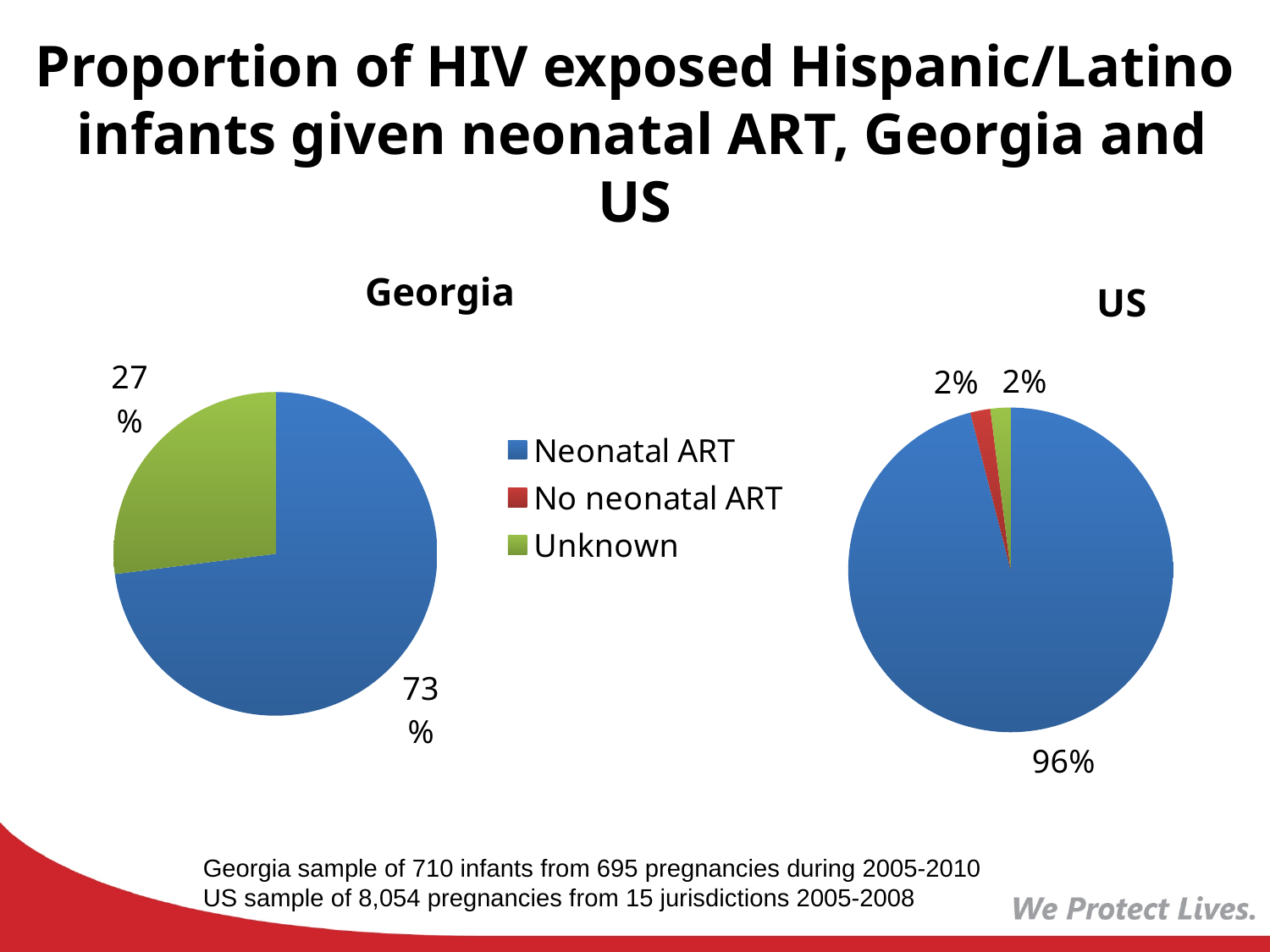
In the Georgia pie chart, what share of infants were given neonatal ART? 73% In the Georgia pie chart, what share is labelled Unknown? 27% In the US pie chart, what share of infants were given neonatal ART? 96% What colour represents Unknown in the legend? Green Which is larger: the Unknown share in the Georgia pie chart or the Unknown share in the US pie chart? Georgia In the Georgia pie chart, which category has the largest slice? Neonatal ART In the US pie chart, which category has the largest slice? Neonatal ART What is the difference between the Neonatal ART share in the US pie chart and the Neonatal ART share in the Georgia pie chart? 23 percentage points How many categories does the legend list? 3 How many slices are visible in the US pie chart? 3 What kind of charts are shown on the slide? Pie charts